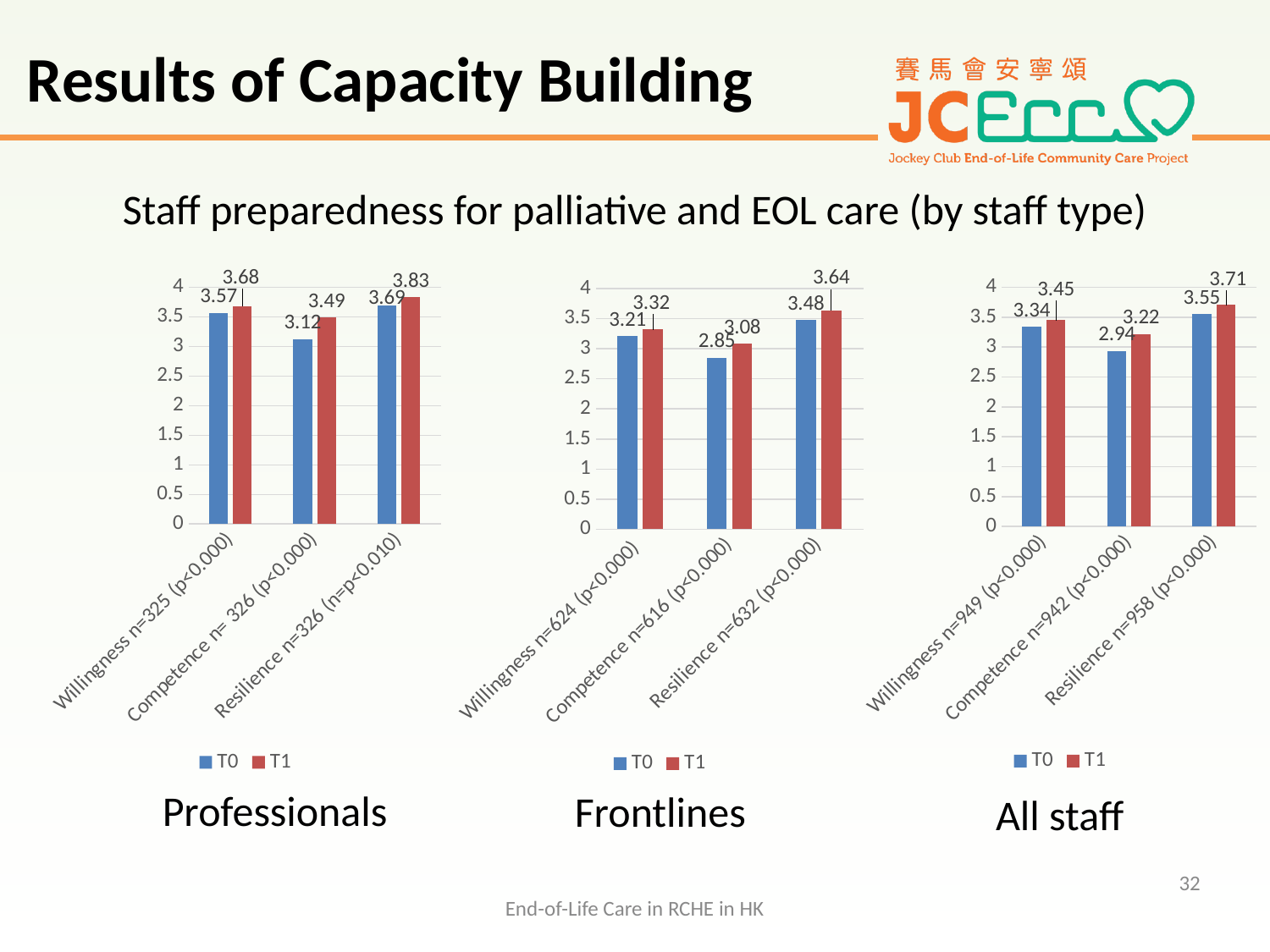
In the Professionals chart, what is the difference between the T1 and T0 values for Competence? 0.37 What kind of chart is the Professionals chart? Bar chart In the Frontlines chart, which category has the highest T1 value? Resilience In the All staff chart, is the T0 value for Competence greater or less than 3? less In the All staff chart, what is the difference between the T1 and T0 values for Competence? 0.28 How many series does the legend of the Frontlines chart list? 2 In the All staff chart, what is the T1 value for Willingness? 3.45 In the Frontlines chart, what is the T0 value for Competence? 2.85 How many categories are shown on the x axis of the All staff chart? 3 In the Professionals chart, which category has the lowest T0 value? Competence In the Professionals chart, what is the T1 value for Resilience? 3.83 In the Frontlines chart, which is larger: the T1 value for Willingness or the T0 value for Resilience? T0 value for Resilience